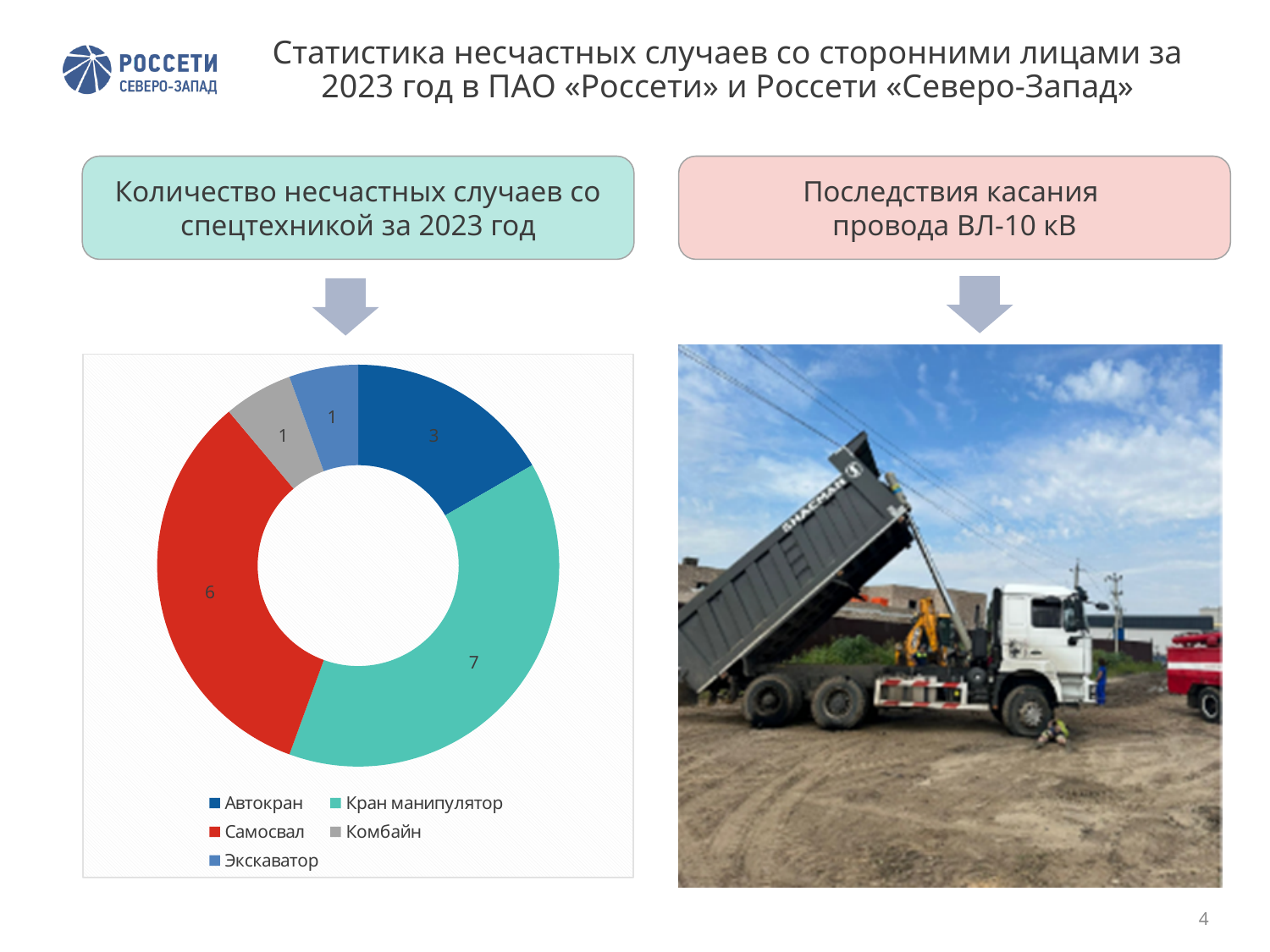
Which is larger, the value for Самосвал or the value for Автокран? Самосвал What is the value for Самосвал in the chart? 6 What is the total number of accidents across all categories in the chart? 18 How many categories does the chart's legend list? 5 What is the value for Комбайн in the chart? 1 What colour represents Самосвал in the chart? Red What is the difference between the values for Кран манипулятор and Самосвал? 1 Which categories share the lowest value in the chart? Комбайн and Экскаватор What is the value for Автокран in the chart? 3 How many accidents are shown for Кран манипулятор in the doughnut chart? 7 Which category has the highest number of accidents in the chart? Кран манипулятор What type of chart is shown on the slide? Doughnut (pie) chart